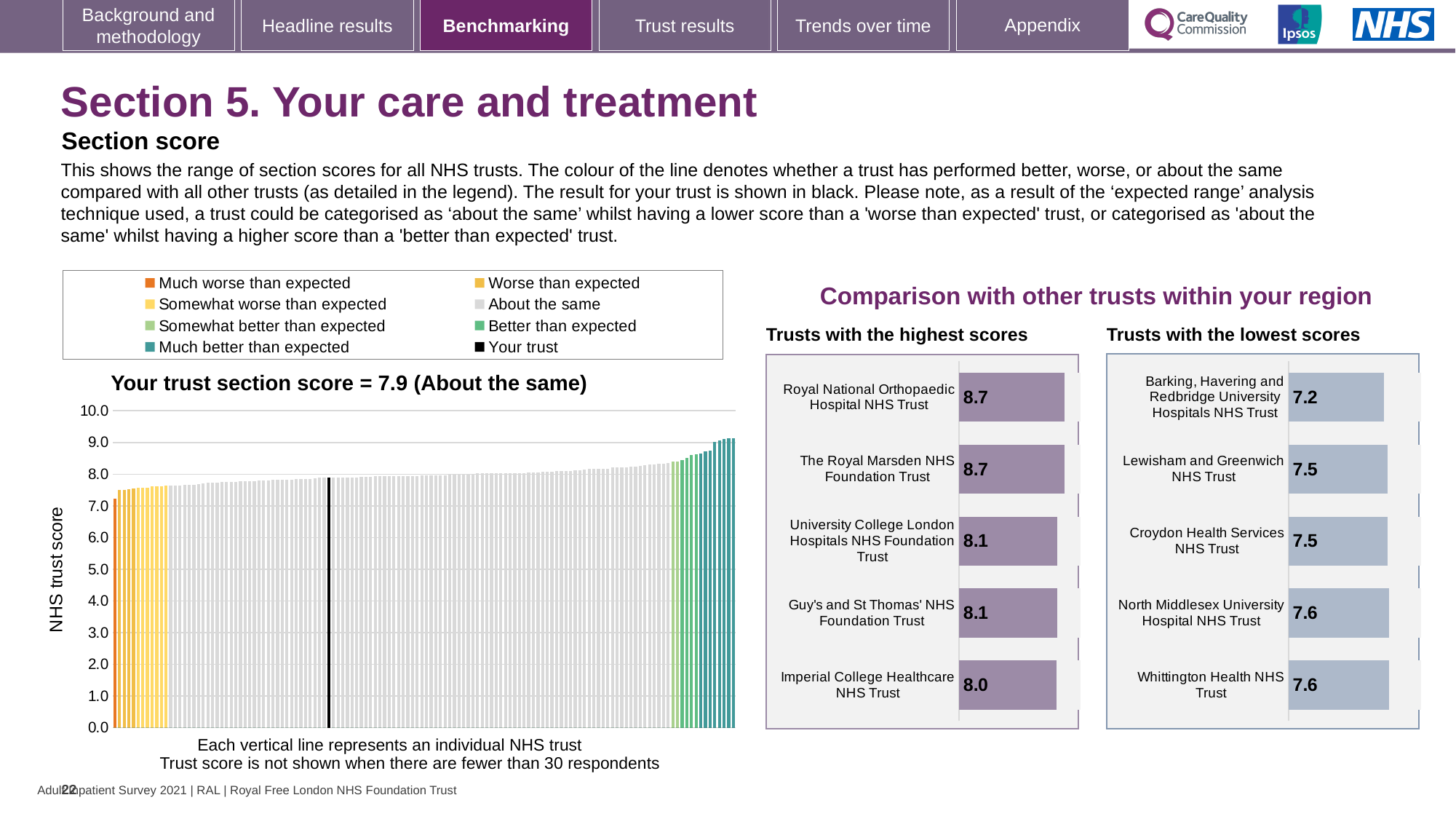
In the 'Trusts with the lowest scores' chart, what is the score for Barking, Havering and Redbridge University Hospitals NHS Trust? 7.2 In the 'Trusts with the highest scores' chart, what is the difference between the scores of Royal National Orthopaedic Hospital NHS Trust and Imperial College Healthcare NHS Trust? 0.7 In the 'Trusts with the lowest scores' chart, what is the difference between the scores of Whittington Health NHS Trust and Barking, Havering and Redbridge University Hospitals NHS Trust? 0.4 According to the title of the main chart on the left, what is your trust's section score? 7.9 How many entries does the legend of the main section score chart on the left list? 8 In the 'Trusts with the highest scores' chart, which has the higher score: University College London Hospitals NHS Foundation Trust or Imperial College Healthcare NHS Trust? University College London Hospitals NHS Foundation Trust In the 'Trusts with the highest scores' chart, what is the score for Imperial College Healthcare NHS Trust? 8.0 In the 'Trusts with the lowest scores' chart, which trust has the lowest score? Barking, Havering and Redbridge University Hospitals NHS Trust How many trusts are shown in the 'Trusts with the highest scores' chart? 5 In the 'Trusts with the lowest scores' chart, what is the score for Croydon Health Services NHS Trust? 7.5 In the 'Trusts with the highest scores' chart, which trust has the lowest score? Imperial College Healthcare NHS Trust In the main section score chart on the left, is the value of the leftmost (lowest) bar greater or less than 8.0? less